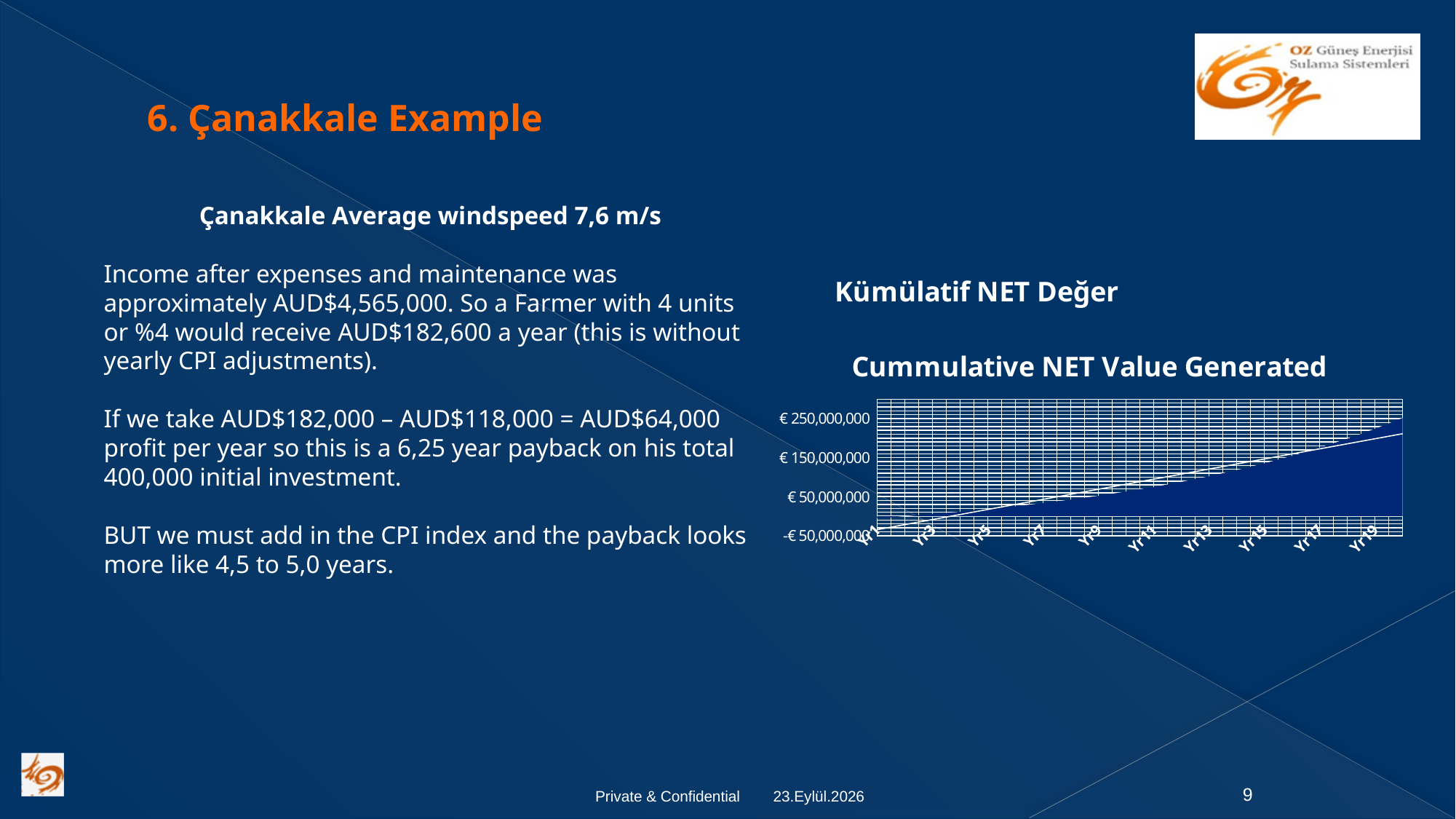
How many year labels are shown on the x axis of the Cummulative NET Value Generated chart? 10 Is the value for Yr3 in the Cummulative NET Value Generated chart greater or less than € 50,000,000? less Which year label has the highest value in the Cummulative NET Value Generated chart? Yr19 Is the value for Yr11 in the Cummulative NET Value Generated chart greater or less than € 50,000,000? greater Is the value for Yr9 in the Cummulative NET Value Generated chart greater or less than € 150,000,000? less In the Cummulative NET Value Generated chart, which is larger, the value for Yr15 or the value for Yr5? Yr15 Do the values in the Cummulative NET Value Generated chart rise or fall from Yr1 to Yr19? rise What is the highest value labelled on the y axis of the Cummulative NET Value Generated chart? € 250,000,000 What kind of chart is shown on the slide? area chart What is the title of the chart on the slide? Kümülatif NET Değer Cummulative NET Value Generated Which year label has the lowest value in the Cummulative NET Value Generated chart? Yr1